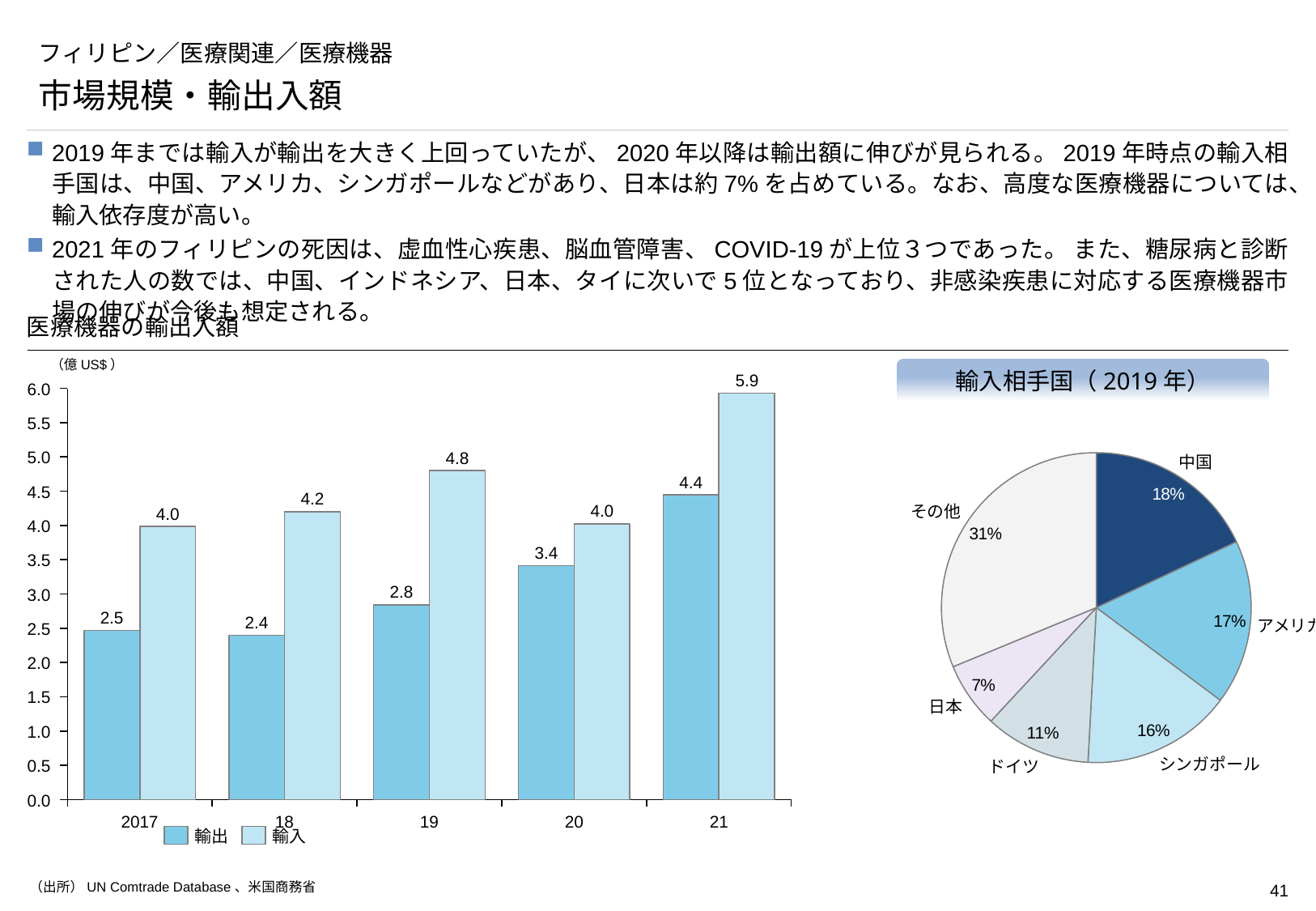
In the bar chart titled 医療機器の輸出入額, how many series does the legend list? 2 In the bar chart titled 医療機器の輸出入額, how many years are shown on the x axis? 5 In the pie chart titled 輸入相手国（2019年）, which named country has the largest share? 中国 In the bar chart titled 医療機器の輸出入額, what is the 輸出 value for 21? 4.4 In the bar chart titled 医療機器の輸出入額, does the 輸出 value rise or fall from 18 to 21? rise In the bar chart titled 医療機器の輸出入額, what is the 輸入 value for 2017? 4.0 In the bar chart titled 医療機器の輸出入額, what is the difference between 輸入 and 輸出 in 19? 2.0 In the bar chart titled 医療機器の輸出入額, which year has the lowest 輸出 value? 18 In the bar chart titled 医療機器の輸出入額, which is larger in 20: 輸出 or 輸入? 輸入 What kind of chart is the one on the right titled 輸入相手国（2019年）? pie chart In the pie chart titled 輸入相手国（2019年）, what share does 日本 have? 7% In the bar chart titled 医療機器の輸出入額, which year has the highest 輸入 value? 21